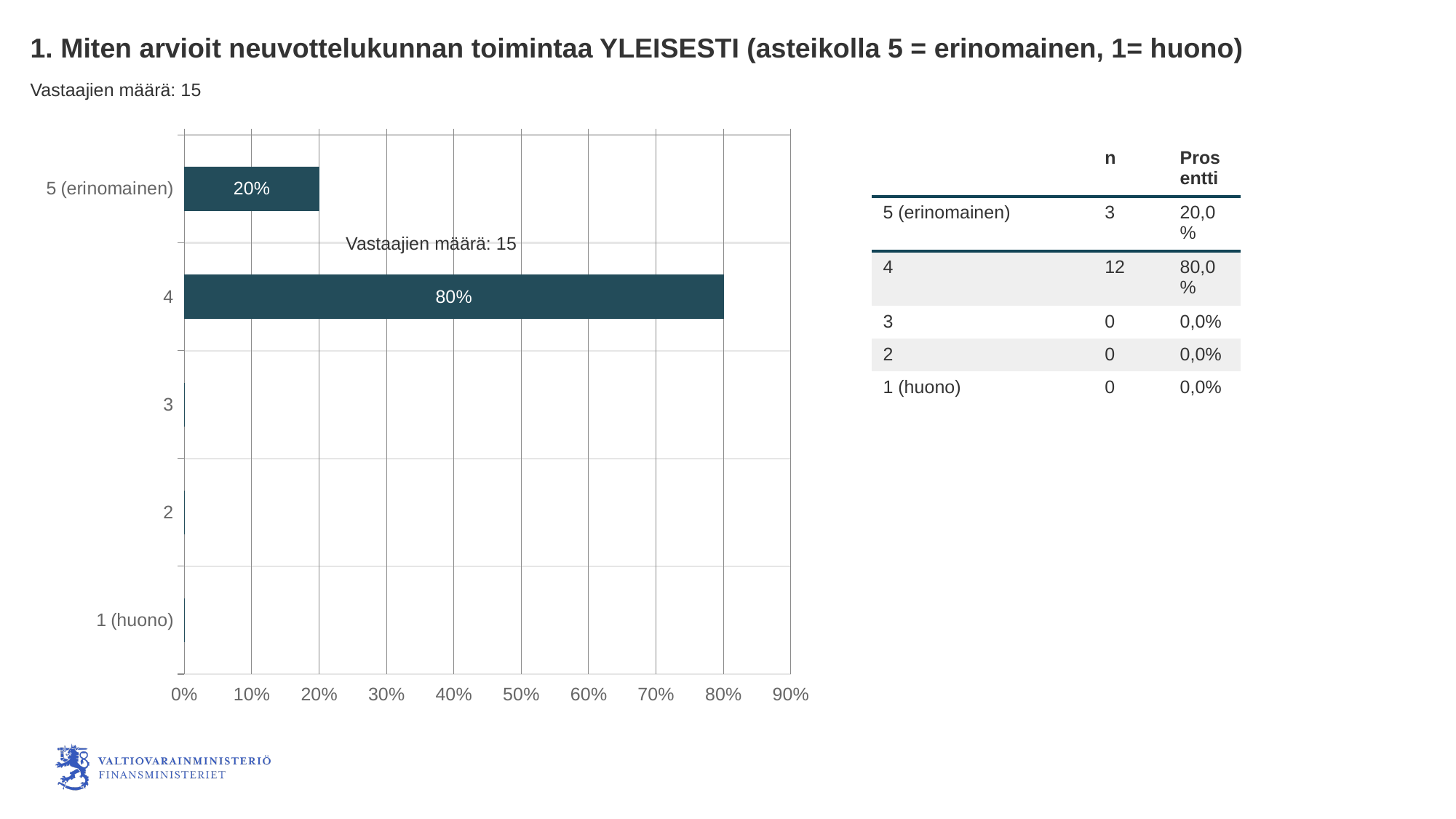
What is the value for category "1 (huono)" in the bar chart? 0,0% What is the difference between the values for category "4" and category "5 (erinomainen)"? 60% Which category has the highest value in the bar chart? 4 What percentage is shown for the category "5 (erinomainen)" in the bar chart? 20% How many categories are shown on the vertical axis of the bar chart? 5 What percentage is shown for the category "4" in the bar chart? 80% What is the value for category "3" in the bar chart? 0,0% What is the highest value shown on the horizontal axis of the bar chart? 90% Is the value for category "4" greater or less than 50%? greater What kind of chart is shown on the slide? bar chart How many respondents (Vastaajien määrä) are reported on the slide? 15 Which is larger: the value for "5 (erinomainen)" or the value for "4"? 4